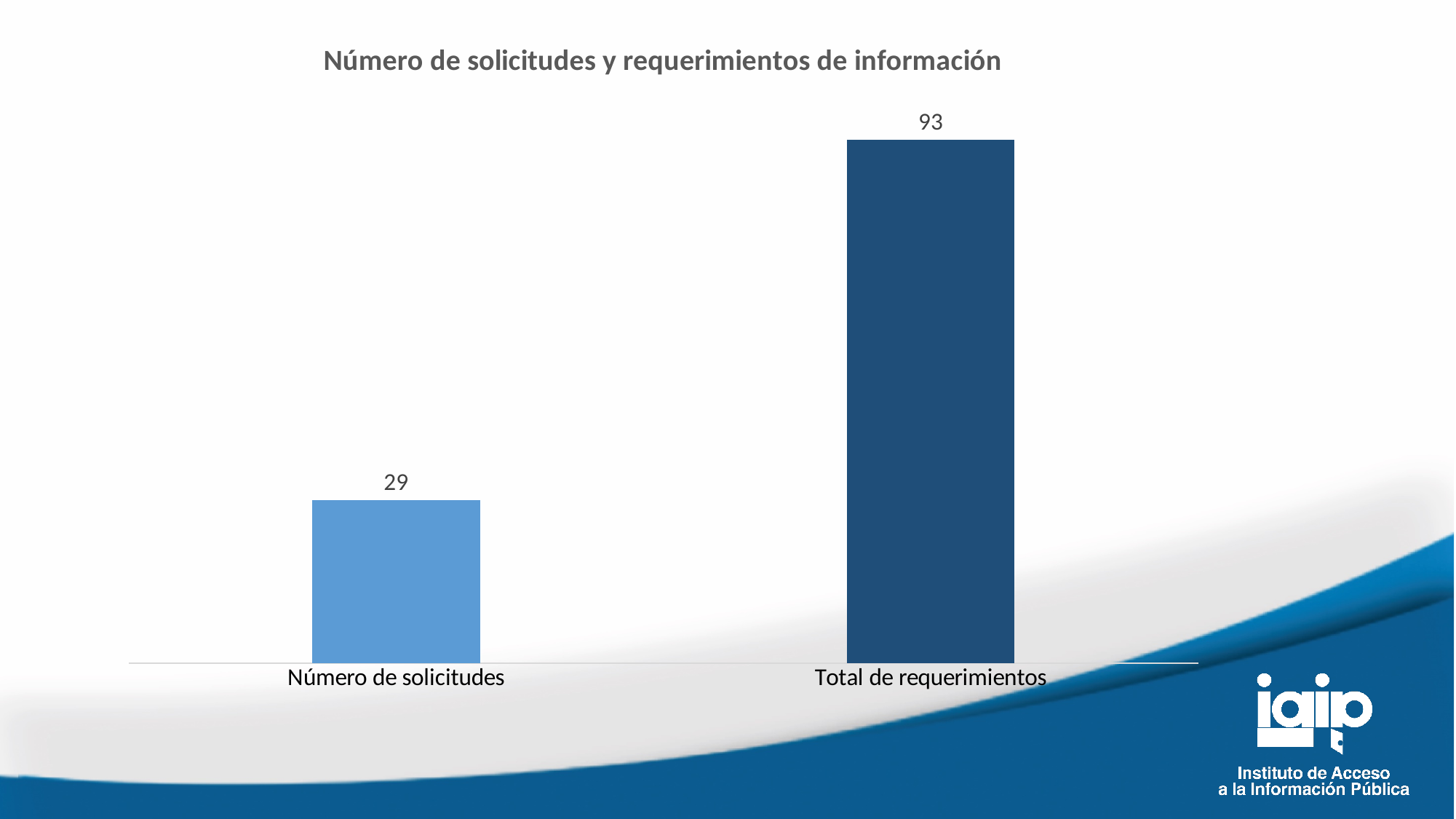
What kind of chart is shown on the slide? Bar chart What is the title of the chart? Número de solicitudes y requerimientos de información What is the value for Número de solicitudes? 29 What colour is the bar for Total de requerimientos? Dark blue What is the value for Total de requerimientos? 93 Which is larger, Número de solicitudes or Total de requerimientos? Total de requerimientos What is the difference between Total de requerimientos and Número de solicitudes? 64 Which category has the lowest value? Número de solicitudes Which category has the highest value? Total de requerimientos How many categories are shown in the chart? 2